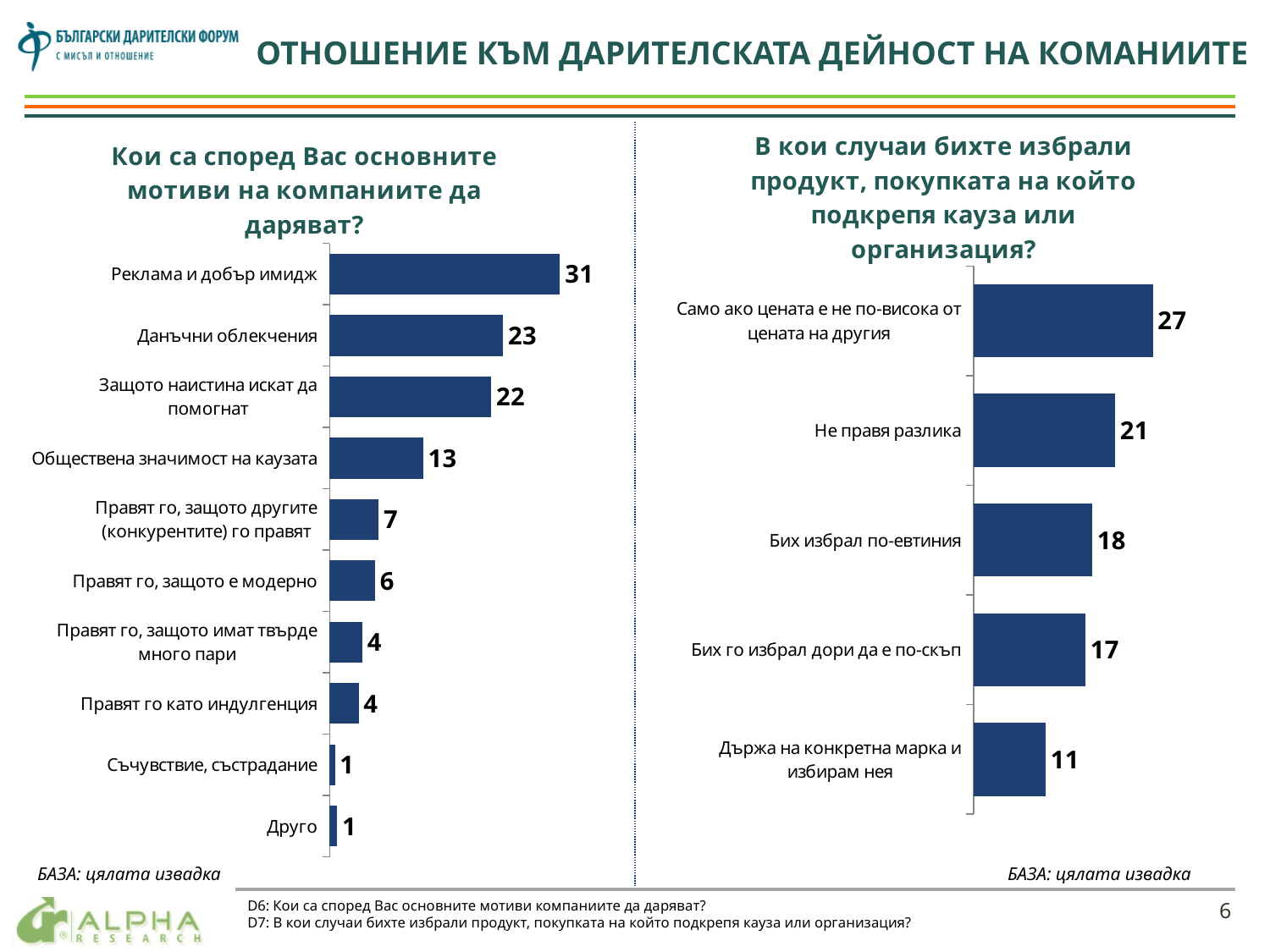
In the left chart ("Кои са според Вас основните мотиви на компаниите да даряват?"), what is the value for "Реклама и добър имидж"? 31 In the left chart ("Кои са според Вас основните мотиви на компаниите да даряват?"), what is the difference between "Данъчни облекчения" and "Защото наистина искат да помогнат"? 1 In the left chart ("Кои са според Вас основните мотиви на компаниите да даряват?"), what is the value for "Обществена значимост на каузата"? 13 In the right chart ("В кои случаи бихте избрали продукт, покупката на който подкрепя кауза или организация?"), which category has the lowest value? Държа на конкретна марка и избирам нея In the left chart ("Кои са според Вас основните мотиви на компаниите да даряват?"), which category has the highest value? Реклама и добър имидж In the right chart ("В кои случаи бихте избрали продукт, покупката на който подкрепя кауза или организация?"), what is the value for "Бих го избрал дори да е по-скъп"? 17 In the left chart ("Кои са според Вас основните мотиви на компаниите да даряват?"), how many categories are shown? 10 What type of chart is the right chart ("В кои случаи бихте избрали продукт, покупката на който подкрепя кауза или организация?")? Bar chart In the right chart ("В кои случаи бихте избрали продукт, покупката на който подкрепя кауза или организация?"), how many categories are shown? 5 In the right chart ("В кои случаи бихте избрали продукт, покупката на който подкрепя кауза или организация?"), what is the difference between "Само ако цената е не по-висока от цената на другия" and "Бих избрал по-евтиния"? 9 In the right chart ("В кои случаи бихте избрали продукт, покупката на който подкрепя кауза или организация?"), what is the value for "Не правя разлика"? 21 In the left chart ("Кои са според Вас основните мотиви на компаниите да даряват?"), which is larger: "Правят го, защото другите (конкурентите) го правят" or "Правят го, защото е модерно"? Правят го, защото другите (конкурентите) го правят